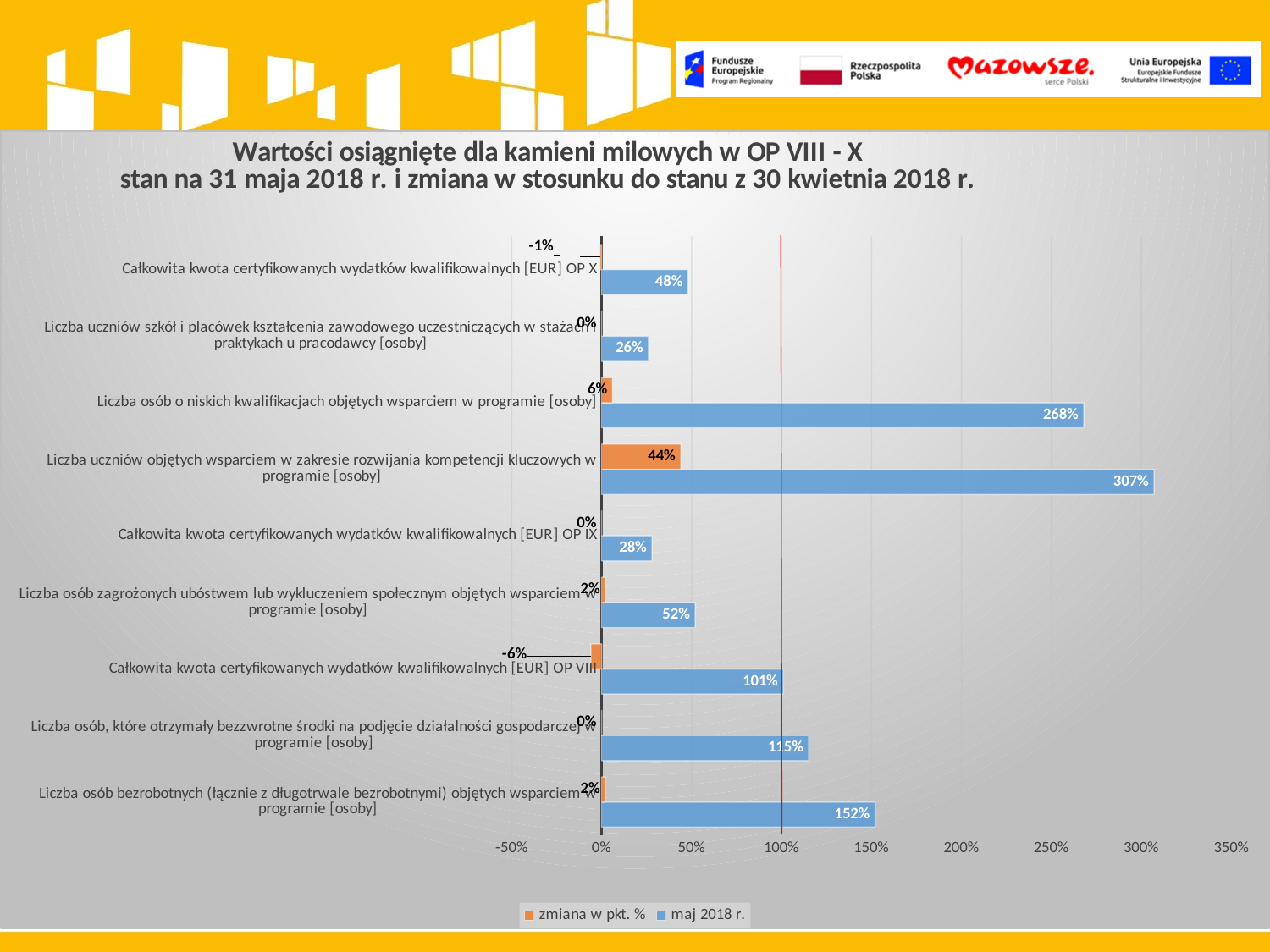
Which has a larger 'maj 2018 r.' value: 'Całkowita kwota certyfikowanych wydatków kwalifikowalnych [EUR] OP X' or 'Całkowita kwota certyfikowanych wydatków kwalifikowalnych [EUR] OP IX'? Całkowita kwota certyfikowanych wydatków kwalifikowalnych [EUR] OP X What is the difference between the 'maj 2018 r.' values for 'Liczba uczniów objętych wsparciem w zakresie rozwijania kompetencji kluczowych w programie [osoby]' and 'Liczba osób o niskich kwalifikacjach objętych wsparciem w programie [osoby]'? 39% What is the 'zmiana w pkt. %' value for 'Całkowita kwota certyfikowanych wydatków kwalifikowalnych [EUR] OP VIII'? -6% What type of chart is shown on the slide? bar chart What is the 'maj 2018 r.' value for 'Liczba osób bezrobotnych (łącznie z długotrwale bezrobotnymi) objętych wsparciem w programie [osoby]'? 152% Which category has the highest 'zmiana w pkt. %' value? Liczba uczniów objętych wsparciem w zakresie rozwijania kompetencji kluczowych w programie [osoby] How many series does the legend list? 2 What is the 'maj 2018 r.' value for 'Liczba uczniów objętych wsparciem w zakresie rozwijania kompetencji kluczowych w programie [osoby]'? 307% Which category has the lowest 'maj 2018 r.' value? Liczba uczniów szkół i placówek kształcenia zawodowego uczestniczących w stażach i praktykach u pracodawcy [osoby] How many categories are plotted on the chart? 9 Which colour represents the 'maj 2018 r.' series? blue Which category has the highest 'maj 2018 r.' value? Liczba uczniów objętych wsparciem w zakresie rozwijania kompetencji kluczowych w programie [osoby]